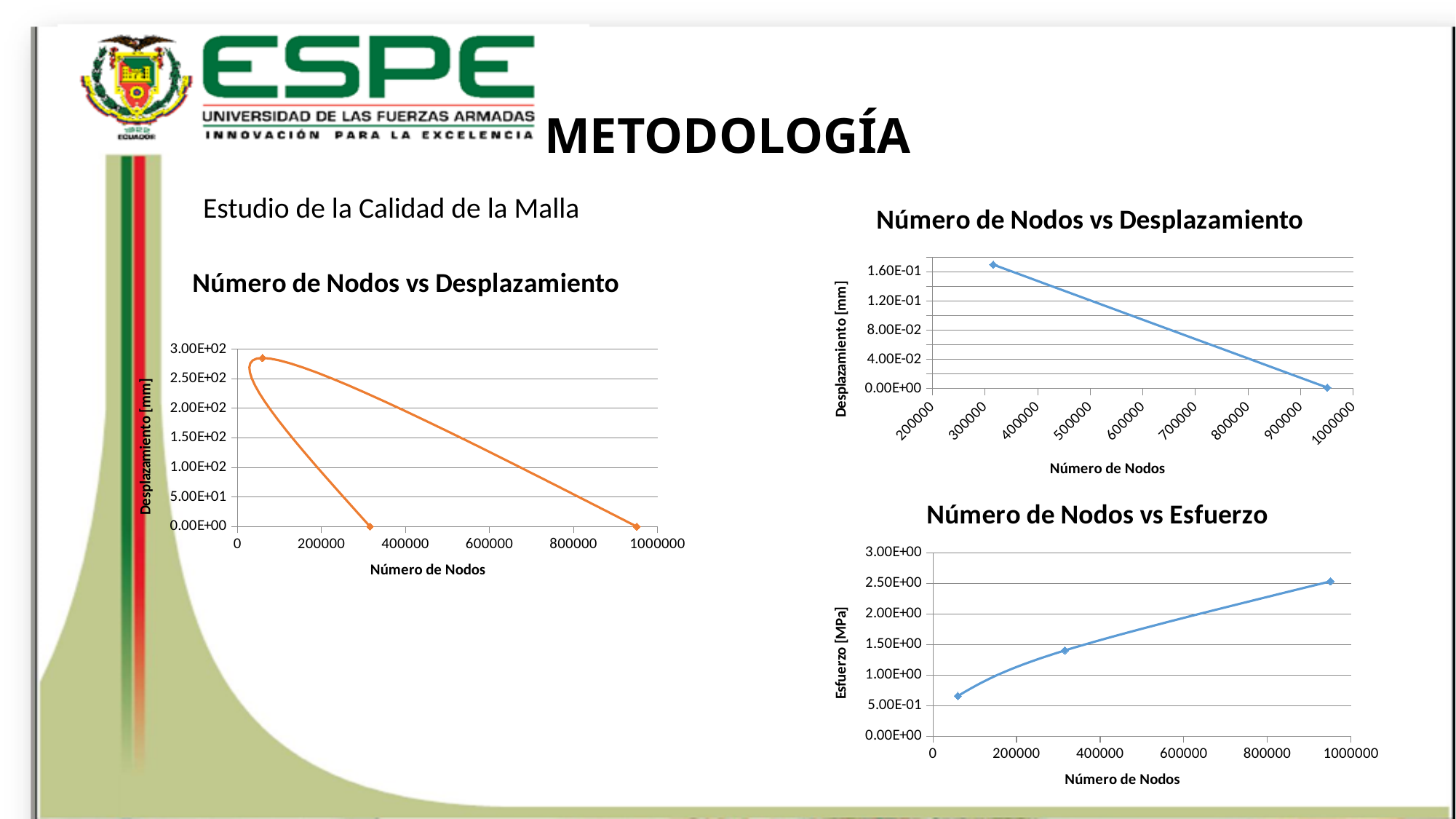
How many charts are shown on the slide? 3 In the top-right chart (Número de Nodos vs Desplazamiento), do the values rise or fall as the number of nodes increases? fall In the left chart (Número de Nodos vs Desplazamiento), how many data points are plotted? 3 In the top-right chart (Número de Nodos vs Desplazamiento), how many data points are plotted? 2 In the bottom-right chart, what is the label of the vertical axis? Esfuerzo [MPa] In the left chart (Número de Nodos vs Desplazamiento), is the highest plotted Desplazamiento value greater or less than 2.50E+02? greater In the bottom-right chart (Número de Nodos vs Esfuerzo), is the Esfuerzo value at the lowest number of nodes greater or less than 1.00E+00? less In the bottom-right chart (Número de Nodos vs Esfuerzo), do the values rise or fall as the number of nodes increases? rise In the bottom-right chart (Número de Nodos vs Esfuerzo), what kind of chart is it? line chart In the bottom-right chart (Número de Nodos vs Esfuerzo), is the Esfuerzo value at the highest number of nodes greater or less than 2.00E+00? greater